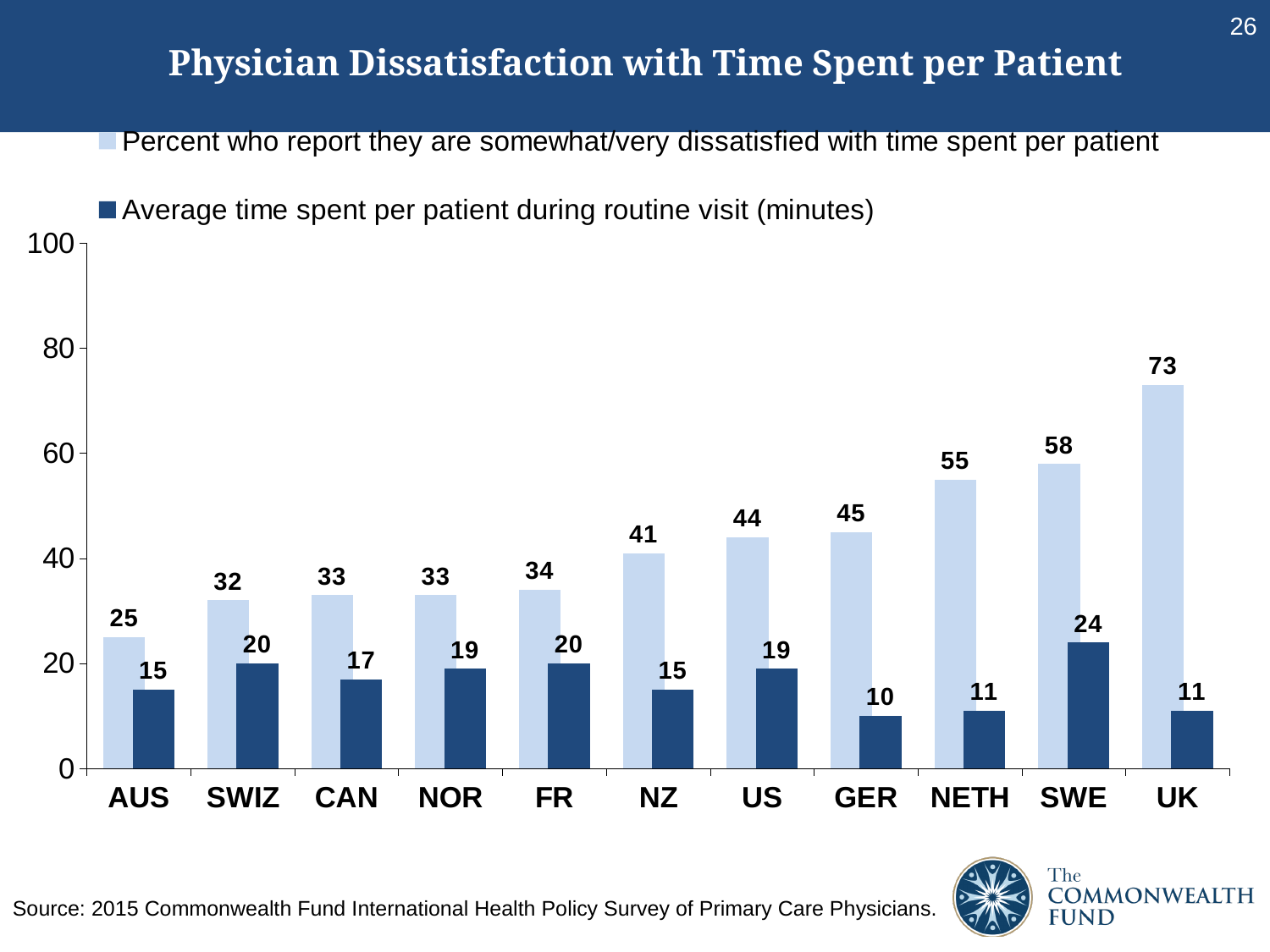
What is the difference between the average time spent per patient in Sweden and in Germany? 14 How many countries are shown on the x axis? 11 What percent of physicians in the UK report they are somewhat/very dissatisfied with time spent per patient? 73 Which country has the lowest average time spent per patient during a routine visit? GER What is the difference between the percent dissatisfied in the UK and in Australia? 48 What is the average time spent per patient during a routine visit in Sweden (minutes)? 24 Which country has the highest percent of physicians dissatisfied with time spent per patient? UK What kind of chart is shown on the slide? Bar chart Which is larger: the average time spent per patient in Sweden or in the US? Sweden Which country has the lowest percent of physicians dissatisfied with time spent per patient? AUS How many series does the legend list? 2 Do the percent dissatisfied values rise or fall from AUS to UK along the x axis? Rise